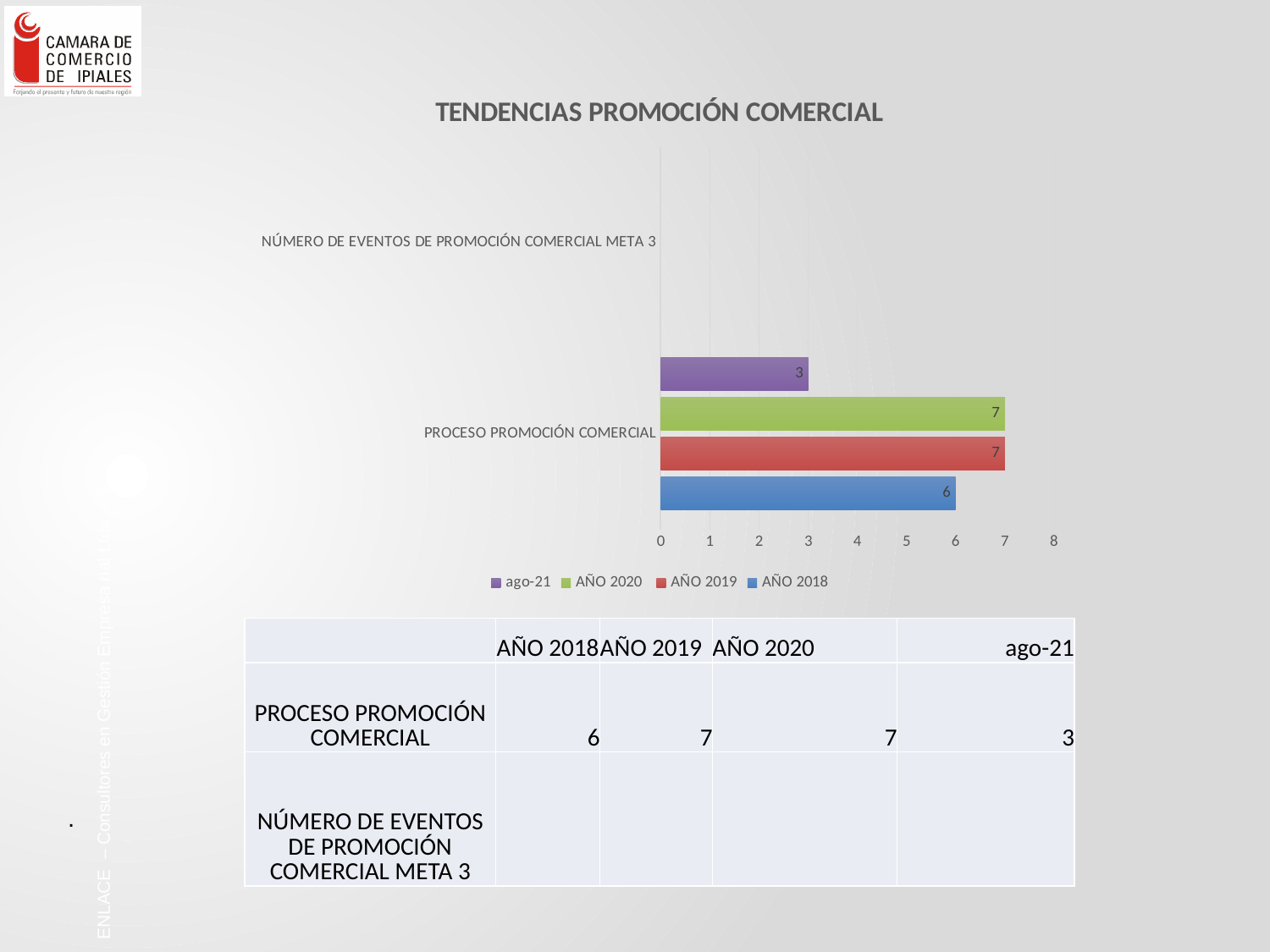
What kind of chart is shown on the slide? Bar chart What is the value for AÑO 2019 in the PROCESO PROMOCIÓN COMERCIAL category? 7 What is the value for ago-21 in the PROCESO PROMOCIÓN COMERCIAL category? 3 Is the ago-21 value for PROCESO PROMOCIÓN COMERCIAL greater or less than 5? less Which series has the lowest value for PROCESO PROMOCIÓN COMERCIAL? ago-21 What is the value for AÑO 2020 in the PROCESO PROMOCIÓN COMERCIAL category? 7 What is the difference between the AÑO 2020 and AÑO 2018 values for PROCESO PROMOCIÓN COMERCIAL? 1 What is the title of the chart? TENDENCIAS PROMOCIÓN COMERCIAL How many series does the legend list? 4 What is the difference between the AÑO 2019 and ago-21 values for PROCESO PROMOCIÓN COMERCIAL? 4 What is the value for AÑO 2018 in the PROCESO PROMOCIÓN COMERCIAL category? 6 Which is larger for PROCESO PROMOCIÓN COMERCIAL: the AÑO 2018 value or the ago-21 value? AÑO 2018